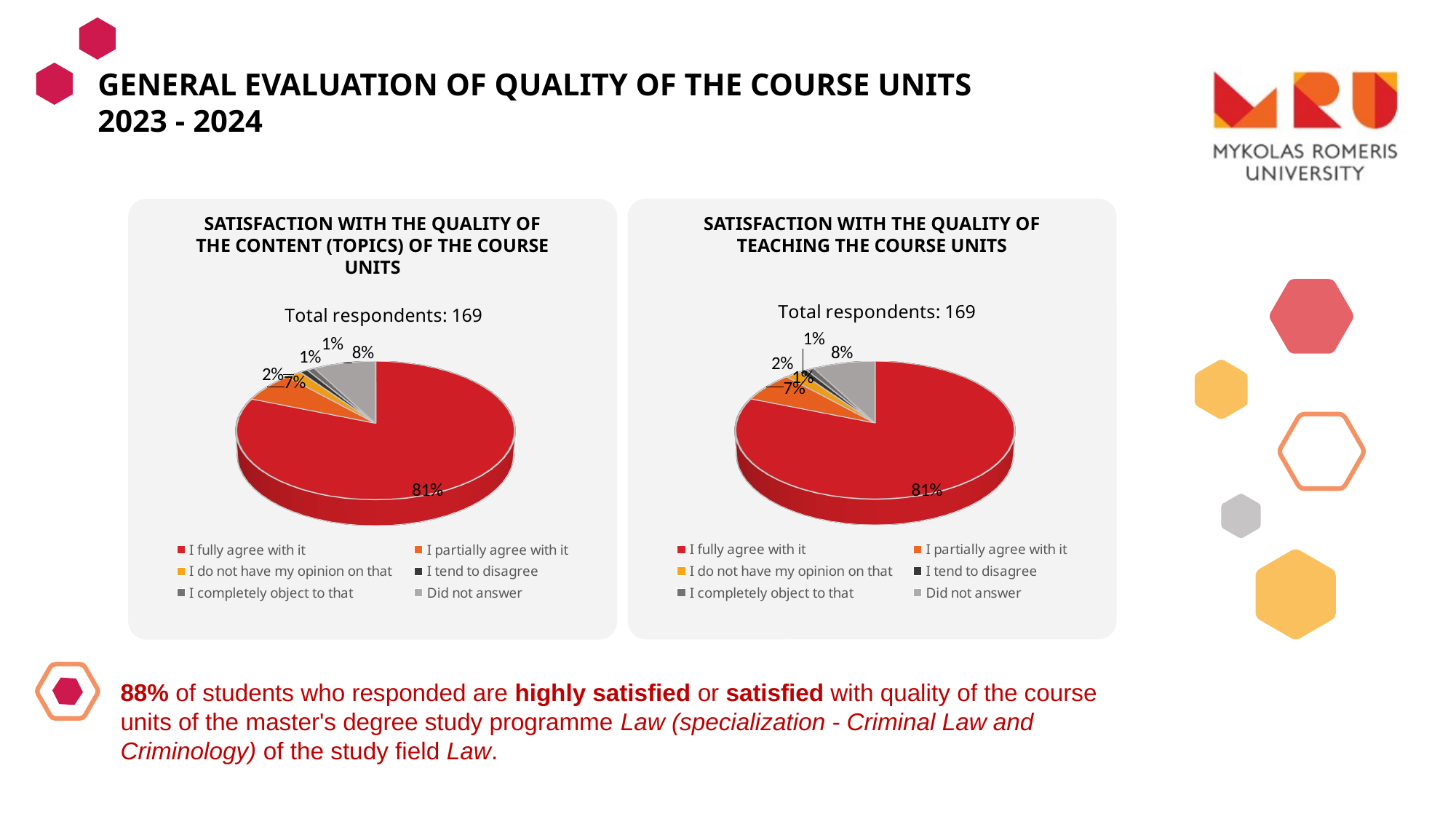
How many total respondents are reported for the left chart (content of the course units)? 169 In the right chart (teaching the course units), what percentage of respondents chose 'I do not have my opinion on that'? 2% In the left chart (content of the course units), what colour is the slice for 'I fully agree with it'? Red What kind of chart is used in the chart titled 'Satisfaction with the quality of teaching the course units'? Pie chart In the left chart (content of the course units), what is the difference between the share for 'I fully agree with it' and the share for 'I partially agree with it'? 74% How many series does the legend of the right chart (teaching the course units) list? 6 In the left chart (content of the course units), which response category has the largest share? I fully agree with it In the chart titled 'Satisfaction with the quality of teaching the course units', what percentage of respondents chose 'I partially agree with it'? 7% In the left chart (content of the course units), what percentage of respondents did not answer? 8% In the right chart (teaching the course units), what is the combined share of 'I fully agree with it' and 'I partially agree with it'? 88% In the right chart (teaching the course units), which is larger: the share for 'Did not answer' or the share for 'I partially agree with it'? Did not answer In the chart titled 'Satisfaction with the quality of the content (topics) of the course units', what percentage of respondents chose 'I fully agree with it'? 81%